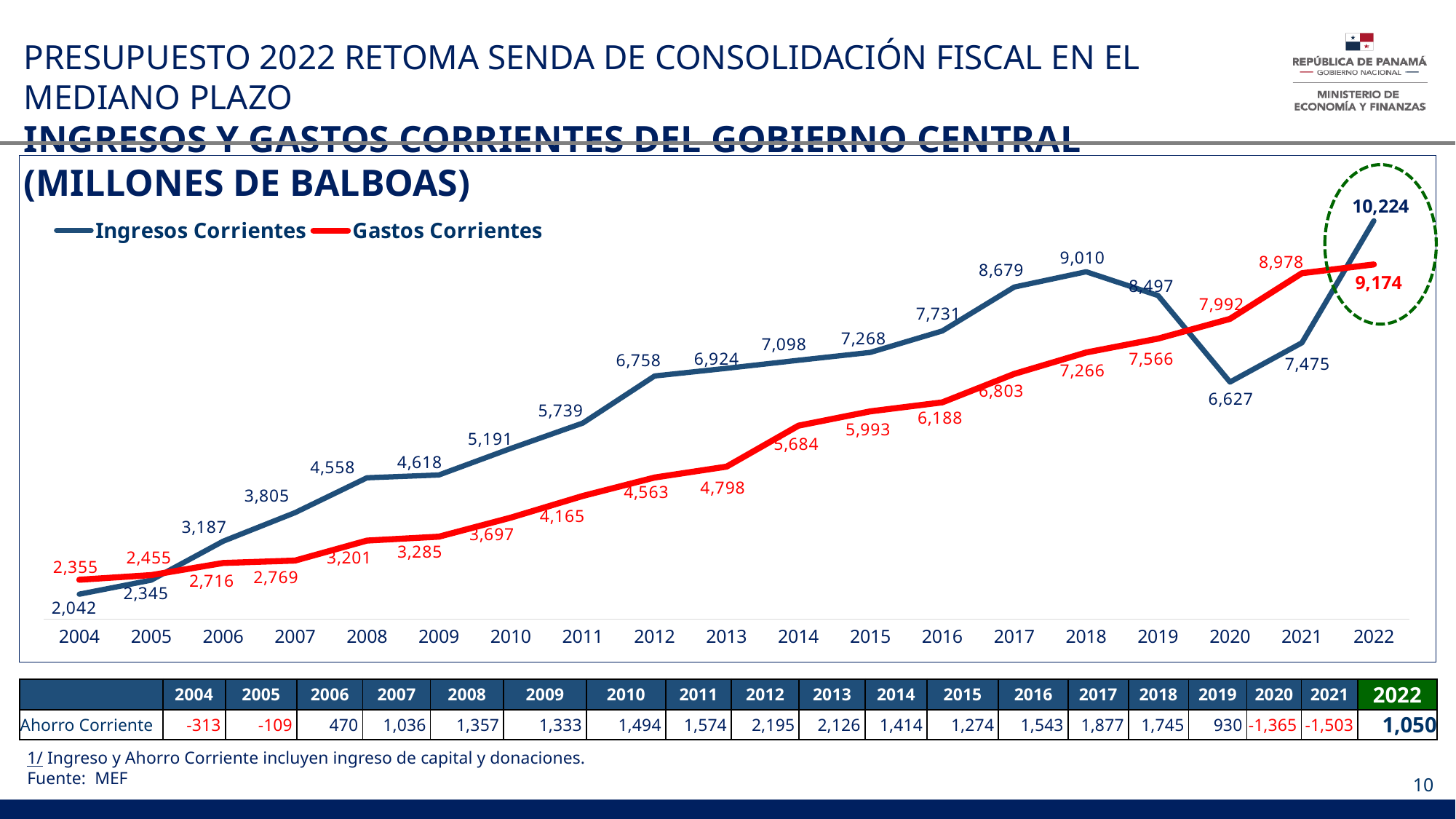
In which year is Gastos Corrientes lowest? 2004 What is the value of Ingresos Corrientes in 2022? 10,224 Which is larger in 2018, Ingresos Corrientes or Gastos Corrientes? Ingresos Corrientes In which year is Ingresos Corrientes highest? 2022 What is the difference between Ingresos Corrientes and Gastos Corrientes in 2022? 1,050 How many series does the chart legend list? 2 What is the value of Gastos Corrientes in 2021? 8,978 What kind of chart is shown on the slide? Line chart How many years are shown on the x axis of the chart? 19 What is the difference between Gastos Corrientes and Ingresos Corrientes in 2020? 1,365 What is the value of Ingresos Corrientes in 2020? 6,627 What is the value of Gastos Corrientes in 2004? 2,355